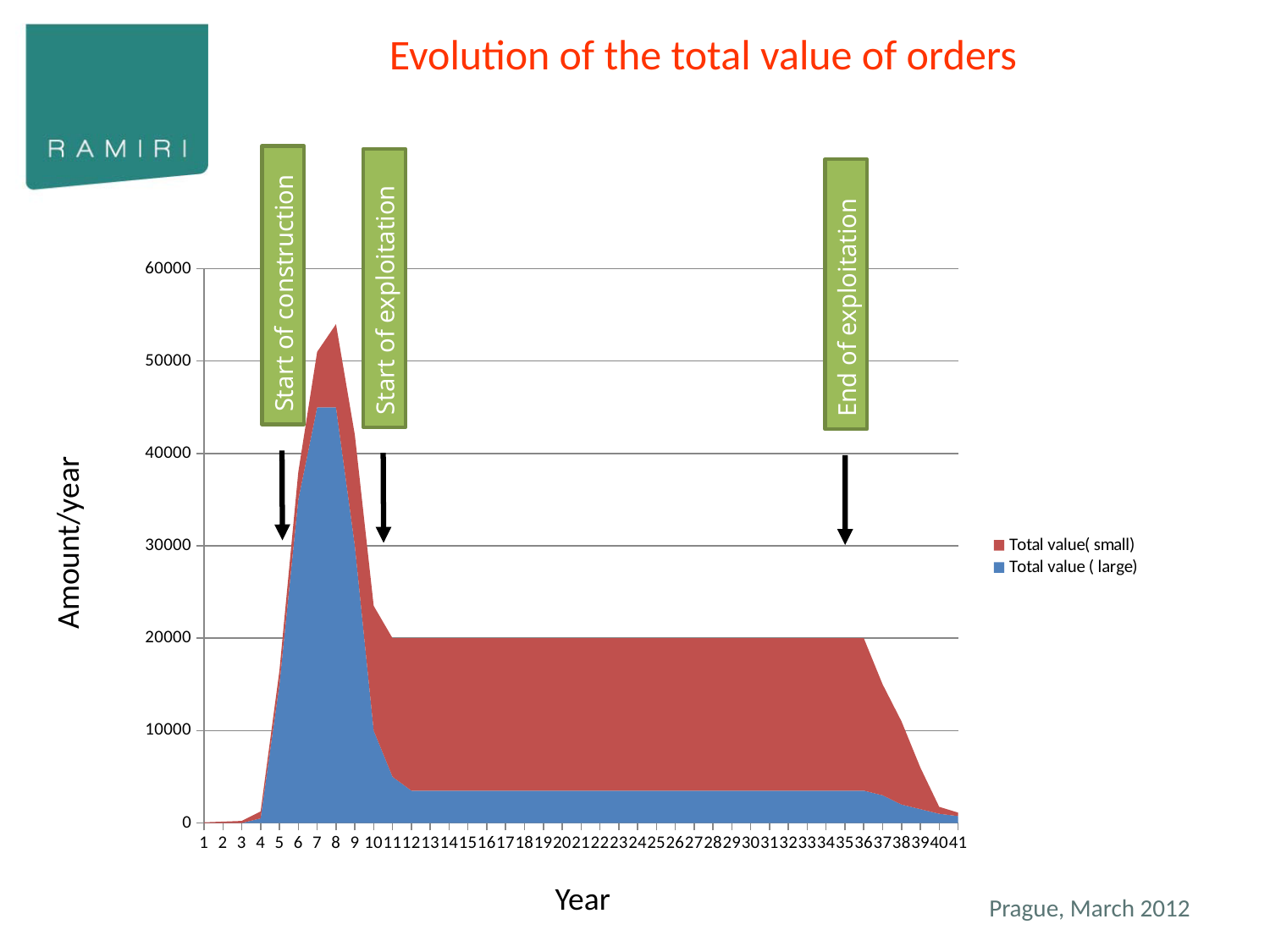
Is the stacked total value at year 8 greater or less than 50000? greater What kind of chart is shown on the slide? Area chart Between year 36 and year 41, does the stacked total value rise or fall? fall Is the value of Total value ( large) at year 20 greater or less than 10000? less How many series does the legend list? 2 What is the title of the chart? Evolution of the total value of orders In which year does the stacked total value reach its highest point? 8 Which series is drawn in blue? Total value ( large) Is the stacked total value at year 20 greater or less than 30000? less Which is larger, the stacked total value at year 8 or at year 20? Year 8 How many years are shown along the x axis? 41